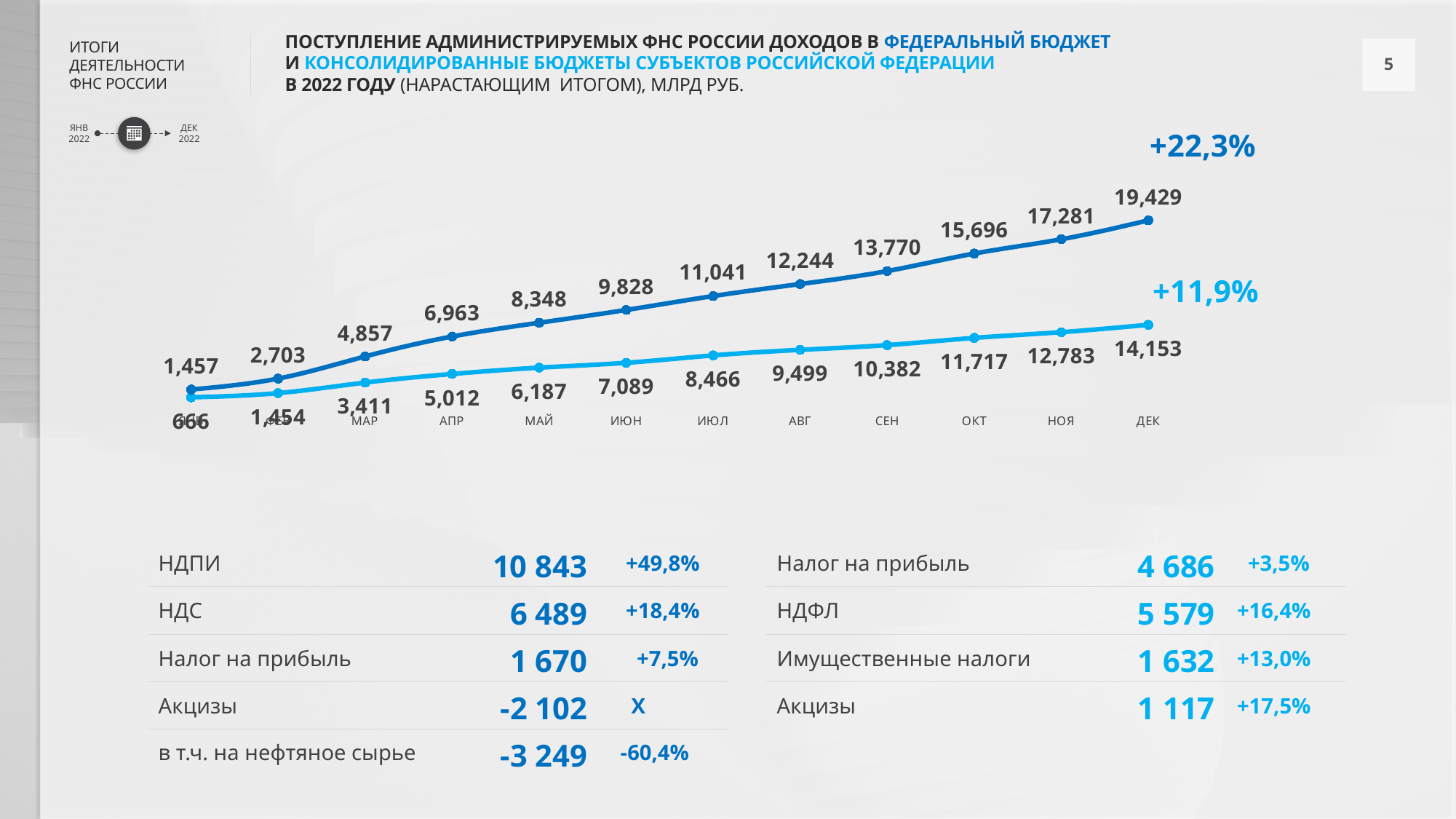
What is the value of the dark blue line (federal budget) at МАР? 4,857 What is the difference between the dark blue line and the light blue line at ДЕК? 5,276 What growth percentage is printed next to the end of the dark blue line (federal budget)? +22,3% What kind of chart is shown on the slide? line chart By how much does the dark blue line (federal budget) increase from ОКТ to НОЯ? 1,585 What is the value of the light blue line (consolidated budgets of subjects) at ДЕК? 14,153 What is the value of the light blue line (consolidated budgets of subjects) at ИЮН? 7,089 How many months are plotted on the x axis of the chart? 12 At СЕН, which line has the higher value, the dark blue (federal budget) or the light blue (consolidated budgets)? dark blue (federal budget) What is the value of the dark blue line (federal budget) at ДЕК? 19,429 At which month does the light blue line reach its highest value? ДЕК Do the values of the dark blue line rise or fall from left to right along the x axis? rise